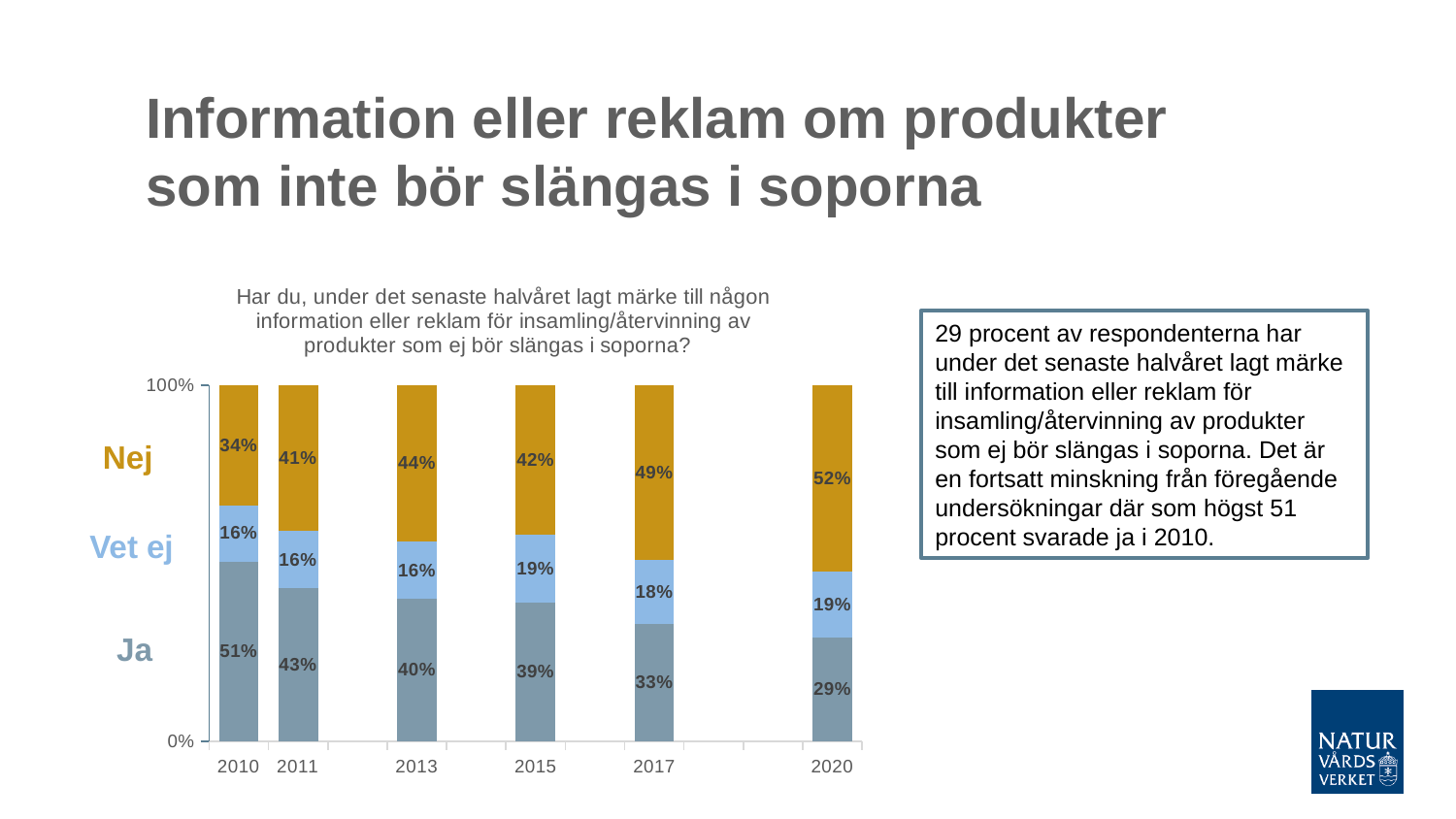
Does the "Ja" share rise or fall from 2010 to 2020? Fall What is the difference in percentage points between the "Ja" share in 2010 and in 2020? 22 Which response category is shown in the orange/gold segments? Nej What percentage answered "Vet ej" in 2015? 19% How many years are shown on the x axis? 6 In which year was the share answering "Nej" lowest? 2010 What percentage answered "Ja" in 2013? 40% In which year was the share answering "Ja" highest? 2010 What type of chart is shown? Stacked bar chart Which is larger in 2017: the "Ja" share or the "Nej" share? Nej What percentage answered "Ja" in 2020? 29% What percentage answered "Nej" in 2010? 34%